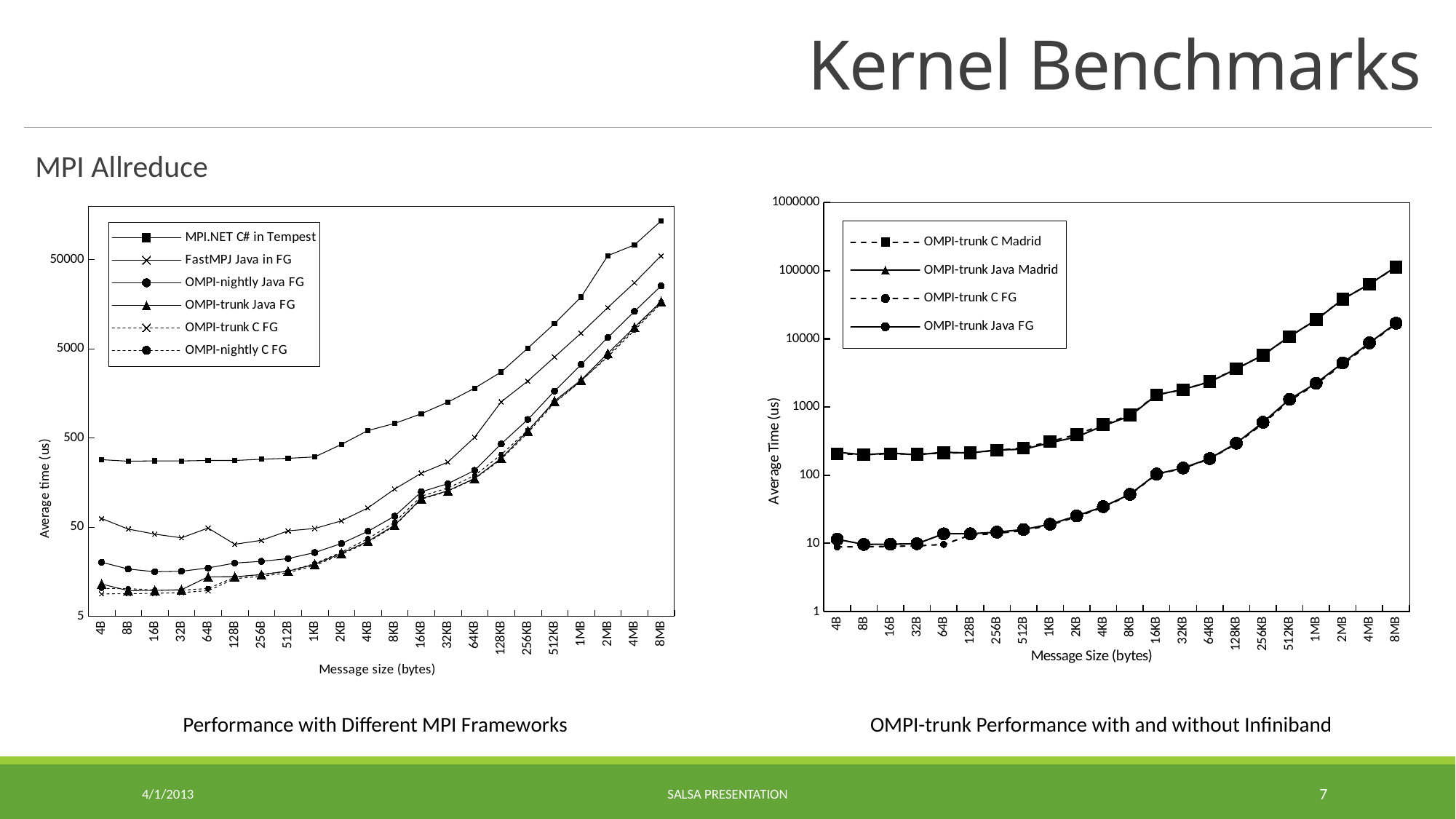
What is the x-axis label of the left chart, 'Performance with Different MPI Frameworks'? Message size (bytes) In the left chart, 'Performance with Different MPI Frameworks', is the value for MPI.NET C# in Tempest at 4B greater or less than 500? less In the right chart, 'OMPI-trunk Performance with and without Infiniband', is the value for OMPI-trunk C Madrid at 4B greater or less than 100? greater In the right chart, 'OMPI-trunk Performance with and without Infiniband', which is larger at 8MB: OMPI-trunk C Madrid or OMPI-trunk Java FG? OMPI-trunk C Madrid How many series does the legend of the left chart, 'Performance with Different MPI Frameworks', list? 6 How many series does the legend of the right chart, 'OMPI-trunk Performance with and without Infiniband', list? 4 What kind of chart is the left chart, 'Performance with Different MPI Frameworks'? line chart In the right chart, 'OMPI-trunk Performance with and without Infiniband', do the values for OMPI-trunk Java FG rise or fall as message size increases from 1KB to 8MB? rise In the right chart, 'OMPI-trunk Performance with and without Infiniband', is the value for OMPI-trunk Java FG at 8MB greater or less than 10000? greater In the left chart, 'Performance with Different MPI Frameworks', which series has the highest average time at 8MB? MPI.NET C# in Tempest How many message sizes are shown on the x axis of the right chart, 'OMPI-trunk Performance with and without Infiniband'? 22